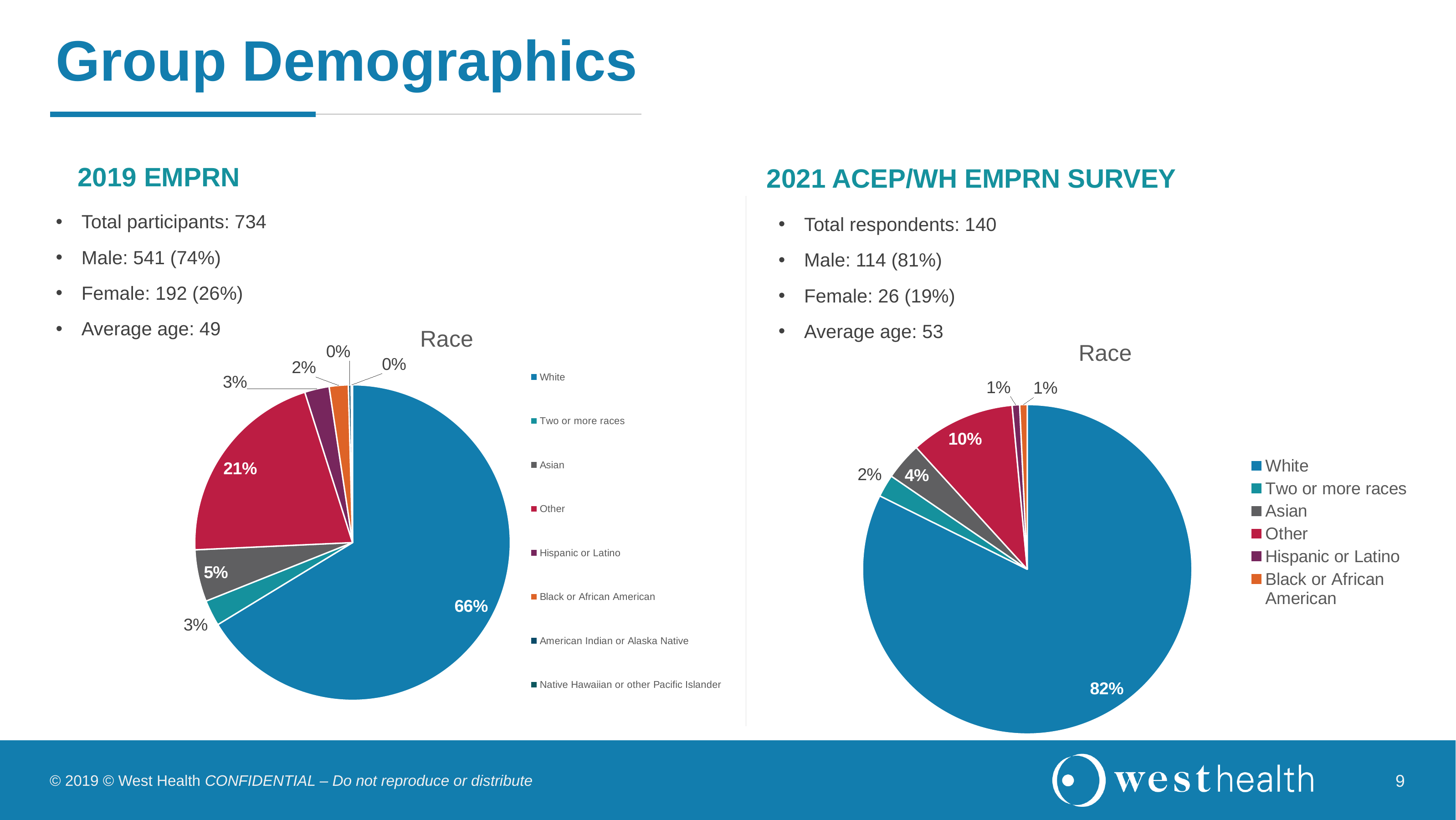
What type of chart is used to show Race in the 2021 ACEP/WH EMPRN SURVEY section on the right? Pie chart In the 2019 EMPRN Race chart on the left, what share of the pie is White? 66% What is the difference between the White share in the 2021 Race chart on the right and the White share in the 2019 Race chart on the left? 16% In the 2019 EMPRN Race chart on the left, what percentage is labelled for Other? 21% In the 2021 ACEP/WH EMPRN SURVEY Race chart on the right, what percentage is labelled for Asian? 4% In the 2019 EMPRN Race chart on the left, which category has the largest slice? White In the 2019 EMPRN Race chart on the left, which slice is larger: Other or Asian? Other In the 2021 ACEP/WH EMPRN SURVEY Race chart on the right, which category has the largest slice? White In the 2021 ACEP/WH EMPRN SURVEY Race chart on the right, what share of the pie is White? 82% How many entries does the legend of the 2019 EMPRN Race chart on the left list? 8 In the 2021 ACEP/WH EMPRN SURVEY Race chart on the right, what percentage is labelled for Other? 10% In the 2019 EMPRN Race chart on the left, what percentage is labelled for Asian? 5%